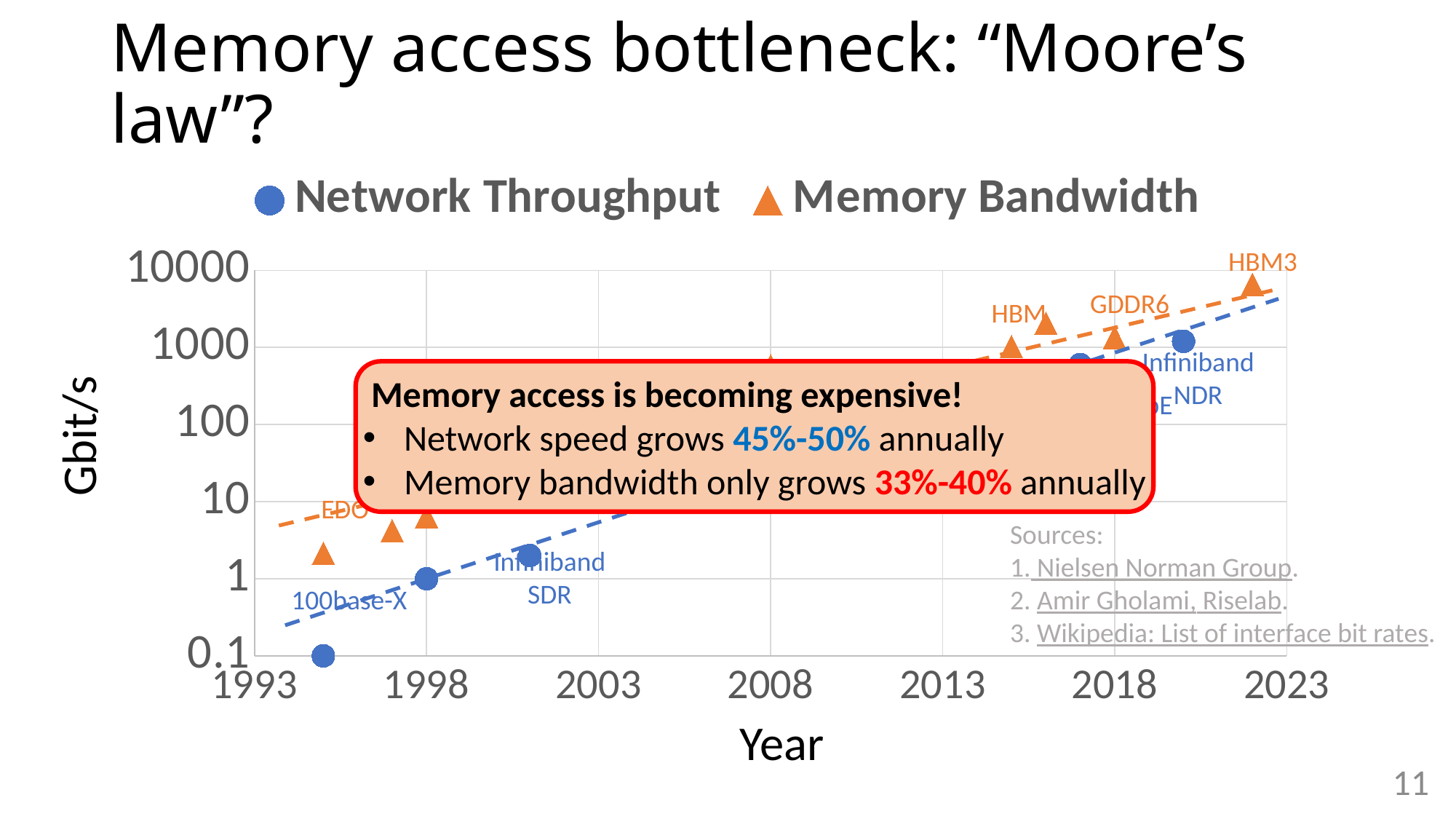
What kind of chart is shown on the slide? scatter chart Which has the higher value, EDO or 100base-X? EDO Which has the higher value, HBM3 or Infiniband NDR? HBM3 How many series does the legend list? 2 Is the value for EDO greater or less than 10 Gbit/s? less Is the value for 100base-X greater or less than 1 Gbit/s? less What unit is shown on the y-axis label? Gbit/s Do the Memory Bandwidth values rise or fall as the year increases? rise Is the value for HBM3 greater or less than 1000 Gbit/s? greater Which labelled point has the highest value on the chart? HBM3 Which two series are listed in the legend? Network Throughput and Memory Bandwidth